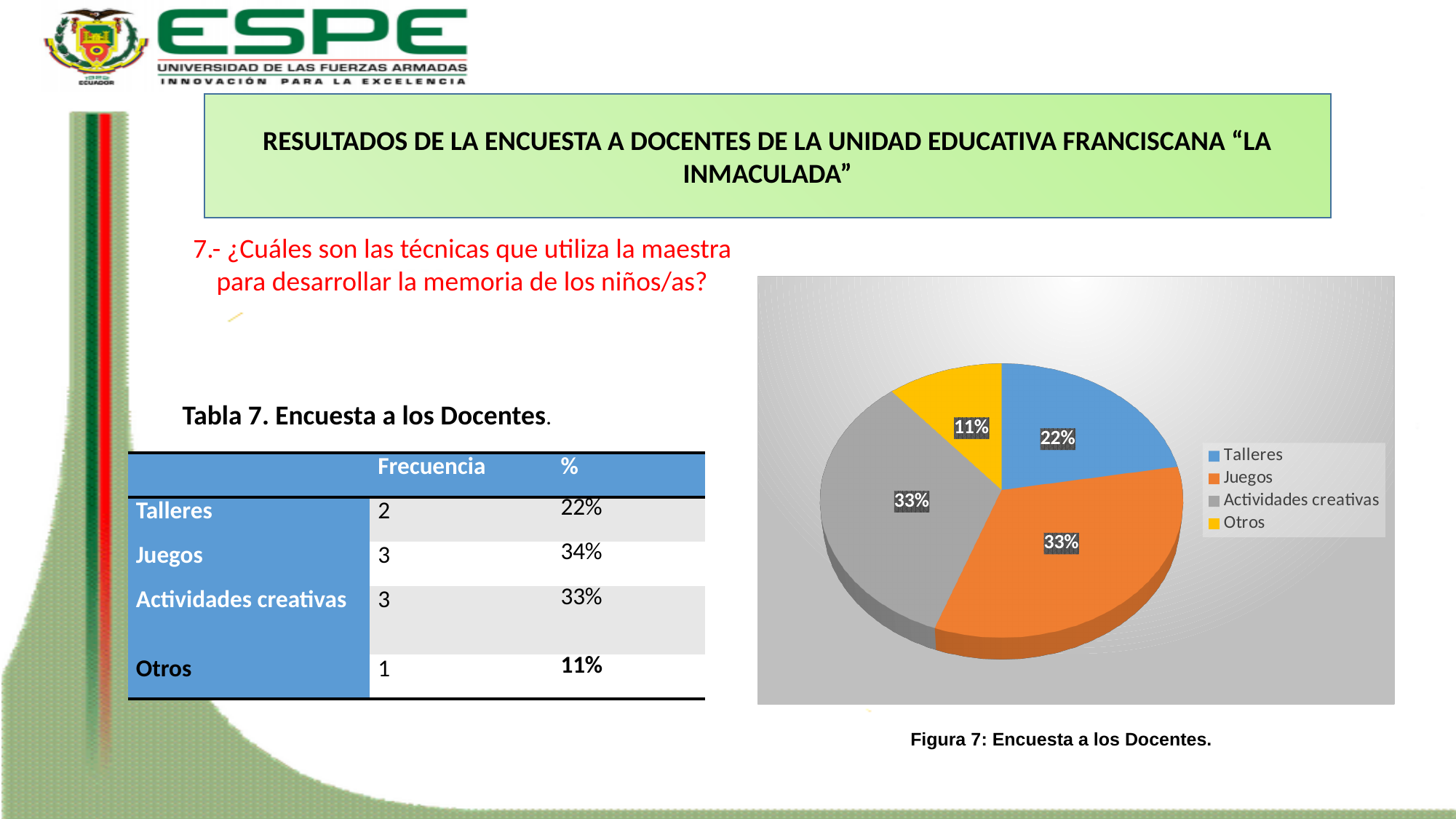
What share of the pie chart does Talleres have? 22% How many slices does the pie chart have? 4 What percentage is shown for Juegos in the pie chart? 33% What is the difference between the Talleres and Otros shares in the pie chart? 11% Which is larger in the pie chart, Actividades creativas or Talleres? Actividades creativas What kind of chart is shown in Figura 7? pie chart Which category has the smallest slice in the pie chart? Otros How many entries does the legend of the pie chart list? 4 Which is larger in the pie chart, Talleres or Otros? Talleres What colour is the Juegos slice in the pie chart? orange What share of the pie chart does Otros have? 11% What percentage is shown for Actividades creativas in the pie chart? 33%